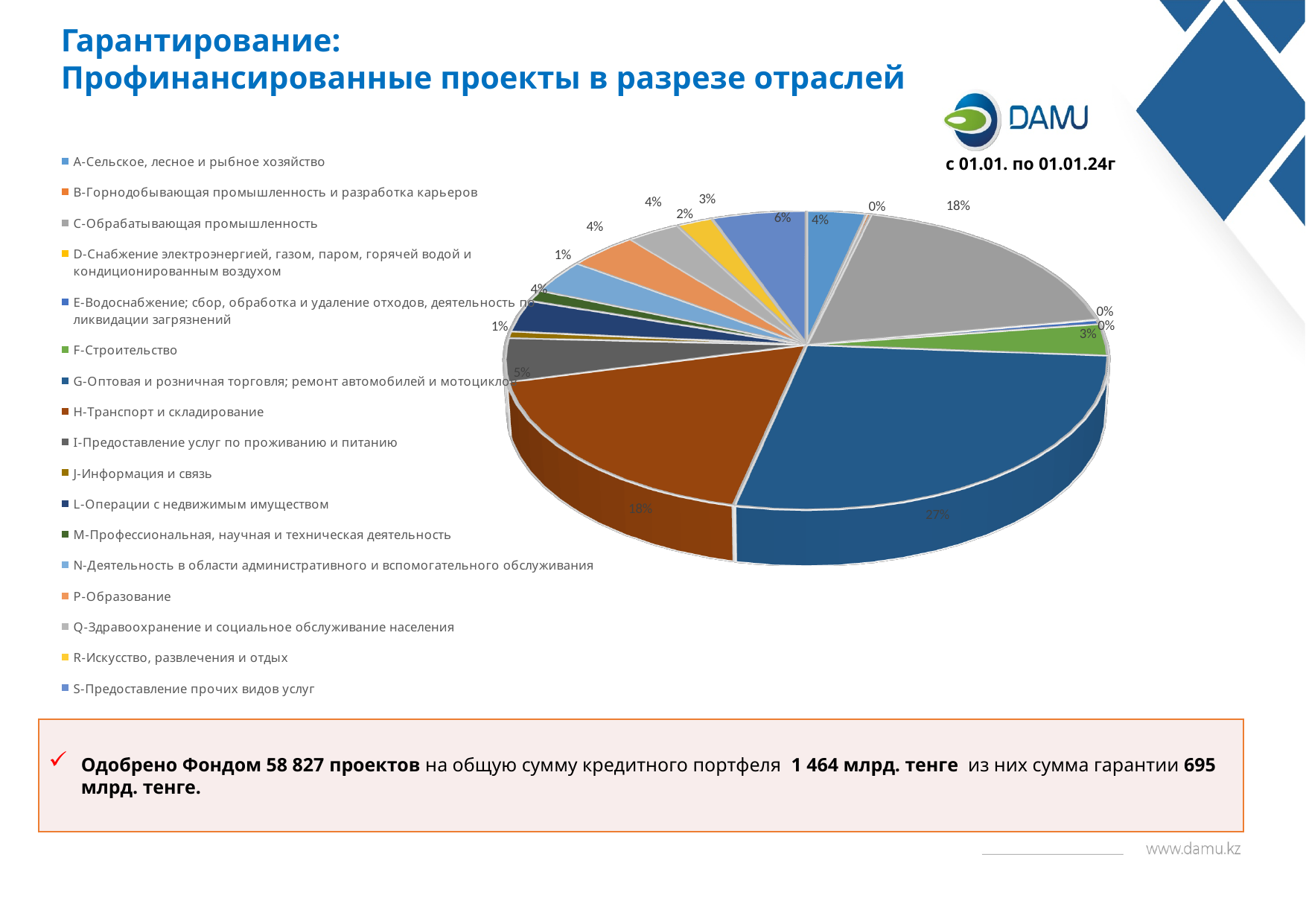
What period is stated above the chart? с 01.01. по 01.01.24г By how many percentage points does the share of G-Оптовая и розничная торговля exceed that of H-Транспорт и складирование? 9 percentage points Which is larger: the share of G-Оптовая и розничная торговля or H-Транспорт и складирование? G-Оптовая и розничная торговля Which industry has the largest share of the pie? G-Оптовая и розничная торговля; ремонт автомобилей и мотоциклов What share does F-Строительство have? 3% What share does H-Транспорт и складирование have? 18% What share does I-Предоставление услуг по проживанию и питанию have? 5% What kind of chart is shown on the slide? pie chart What share does C-Обрабатывающая промышленность have? 18% What share does A-Сельское, лесное и рыбное хозяйство have? 4% What share does G-Оптовая и розничная торговля; ремонт автомобилей и мотоциклов have? 27% How many industry categories does the legend list? 17